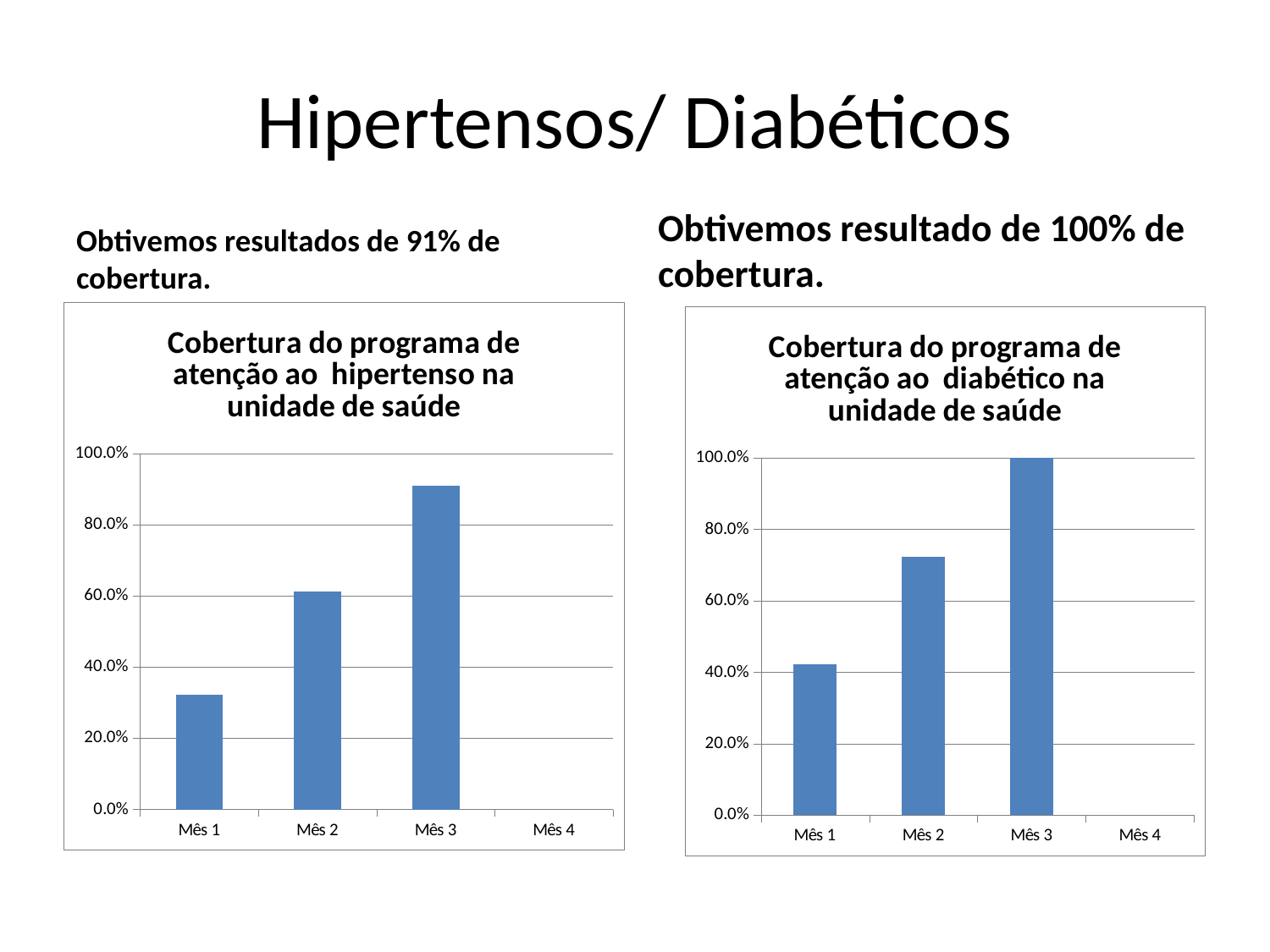
In the 'Cobertura do programa de atenção ao diabético na unidade de saúde' chart, which month has the highest value? Mês 3 In the 'Cobertura do programa de atenção ao hipertenso na unidade de saúde' chart, which month with a visible bar has the lowest value? Mês 1 In the 'Cobertura do programa de atenção ao diabético na unidade de saúde' chart, is the value for Mês 2 greater or less than 80.0%? less In the 'Cobertura do programa de atenção ao hipertenso na unidade de saúde' chart, do the values rise or fall from Mês 1 to Mês 3? rise How many month categories are shown on the x axis of the 'Cobertura do programa de atenção ao diabético na unidade de saúde' chart? 4 In the 'Cobertura do programa de atenção ao hipertenso na unidade de saúde' chart, which is larger, the value for Mês 2 or Mês 3? Mês 3 In the 'Cobertura do programa de atenção ao hipertenso na unidade de saúde' chart, is the value for Mês 1 greater or less than 40.0%? less What is the title of the chart on the right side of the slide? Cobertura do programa de atenção ao diabético na unidade de saúde In the 'Cobertura do programa de atenção ao diabético na unidade de saúde' chart, is the value for Mês 1 greater or less than 40.0%? greater What kind of chart is the 'Cobertura do programa de atenção ao hipertenso na unidade de saúde' chart? bar chart In the 'Cobertura do programa de atenção ao diabético na unidade de saúde' chart, what is the value for Mês 3? 100.0%